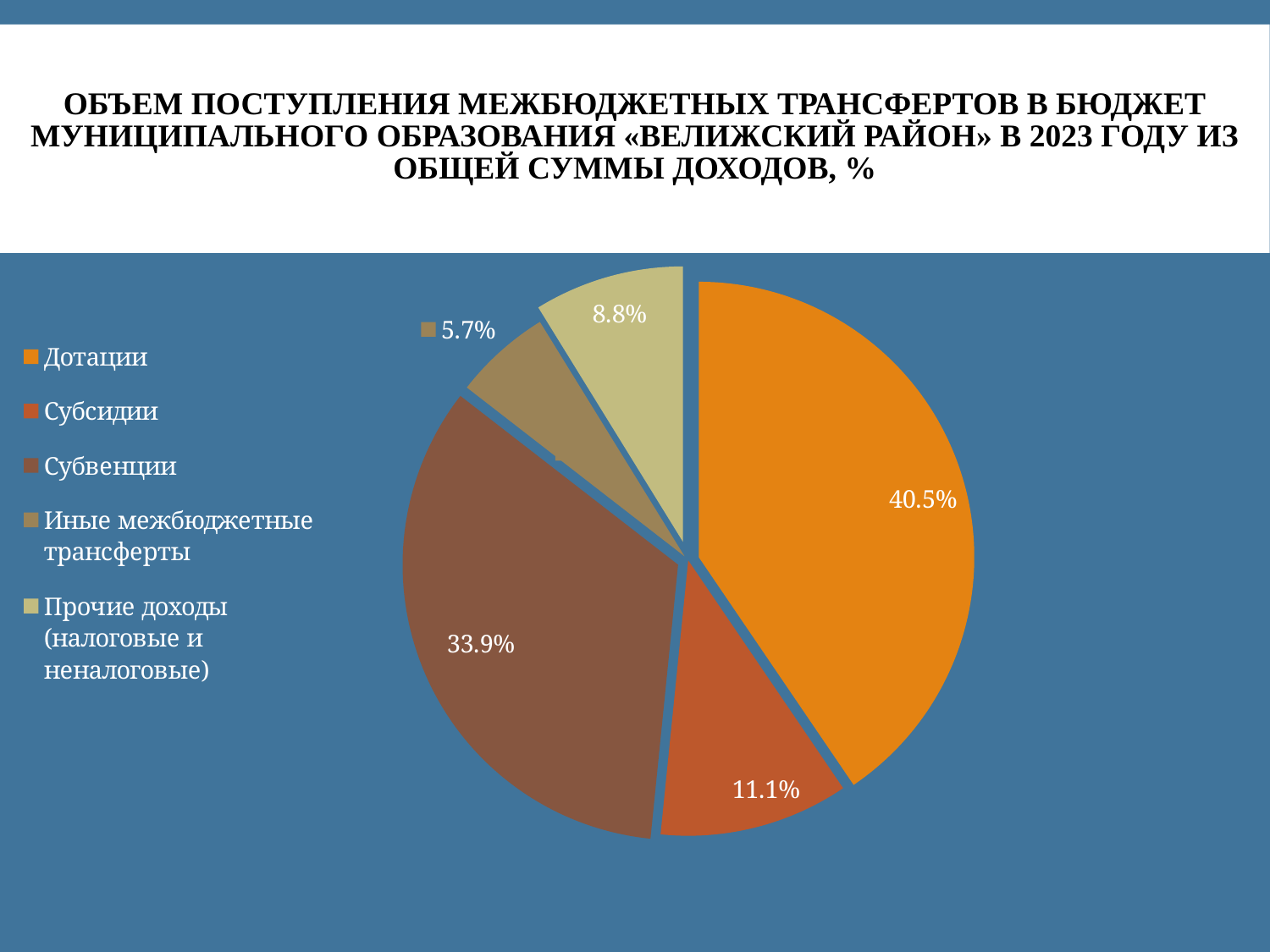
What kind of chart is shown on the slide? pie chart What share of the pie does Иные межбюджетные трансферты have? 5.7% What share of the pie does Прочие доходы (налоговые и неналоговые) have? 8.8% What share of the pie does Дотации have? 40.5% What share of the pie does Субвенции have? 33.9% Which category has the largest slice of the pie? Дотации Which is larger, the share for Субсидии or the share for Прочие доходы (налоговые и неналоговые)? Субсидии What is the difference in percentage points between Дотации and Субвенции? 6.6 How many slices does the pie chart have? 5 What colour is the slice for Дотации? orange Which category has the smallest slice of the pie? Иные межбюджетные трансферты What share of the pie does Субсидии have? 11.1%